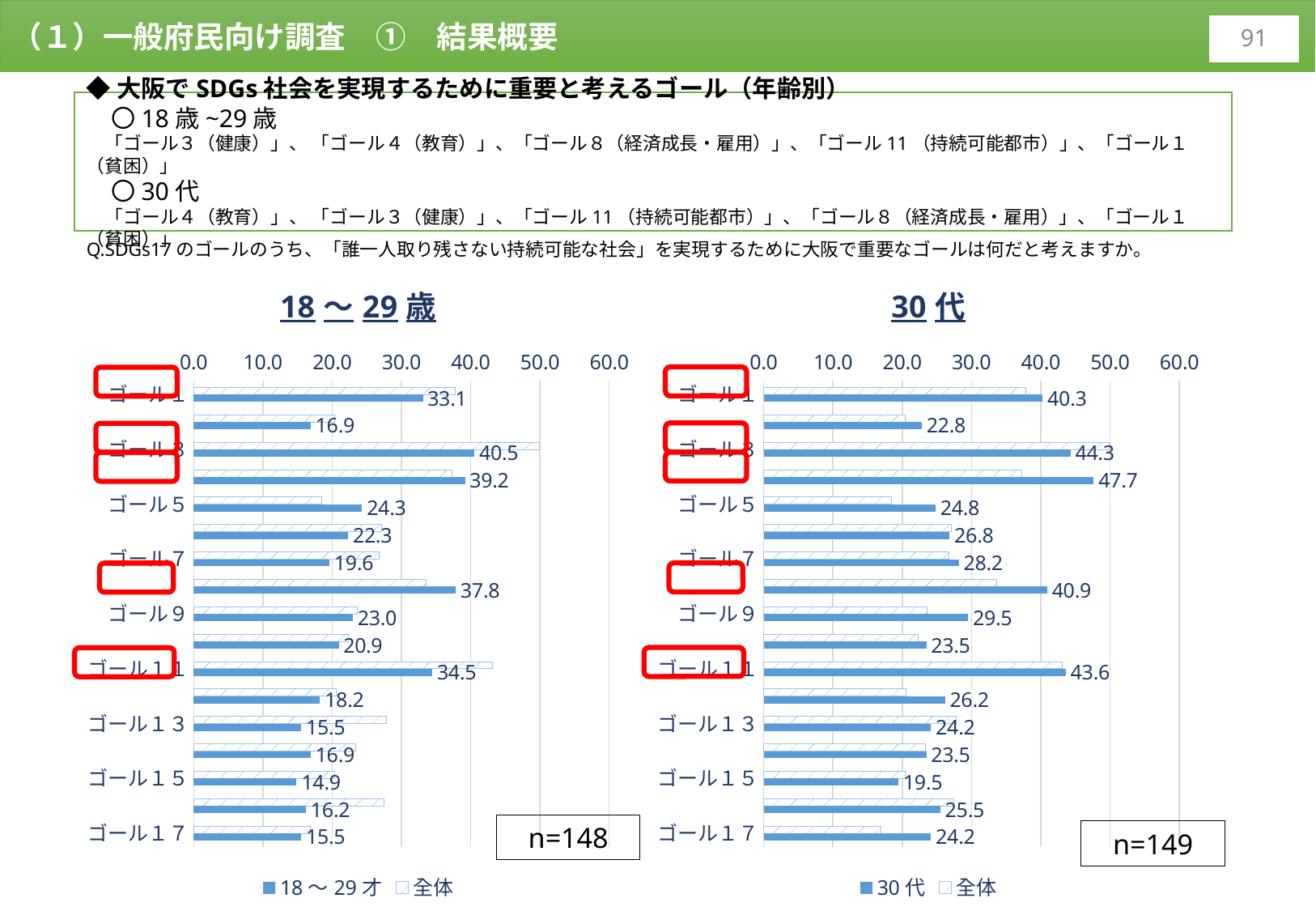
In the 18～29歳 chart, is the 全体 value for ゴール3 greater or less than 40.0? greater In the 30代 chart, which labeled goal has the lowest value in the 30代 series? ゴール15 In the 30代 chart, what is the value of the 30代 series for ゴール7? 28.2 In the 18～29歳 chart, what is the value of the 18～29才 series for ゴール1? 33.1 In the 18～29歳 chart, what is the value of the 18～29才 series for ゴール13? 15.5 What type of chart is used for the 18～29歳 chart? bar chart What sample size (n) is shown for the 30代 chart? n=149 In the 18～29歳 chart, what is the difference between the 18～29才 values for ゴール3 and ゴール1? 7.4 In the 30代 chart, what is the value of the 30代 series for ゴール11? 43.6 In the 30代 chart, which is larger in the 30代 series: ゴール1 or ゴール5? ゴール1 In the 18～29歳 chart, which labeled goal has the highest value in the 18～29才 series? ゴール3 In the 18～29歳 chart, how many series does the legend list? 2